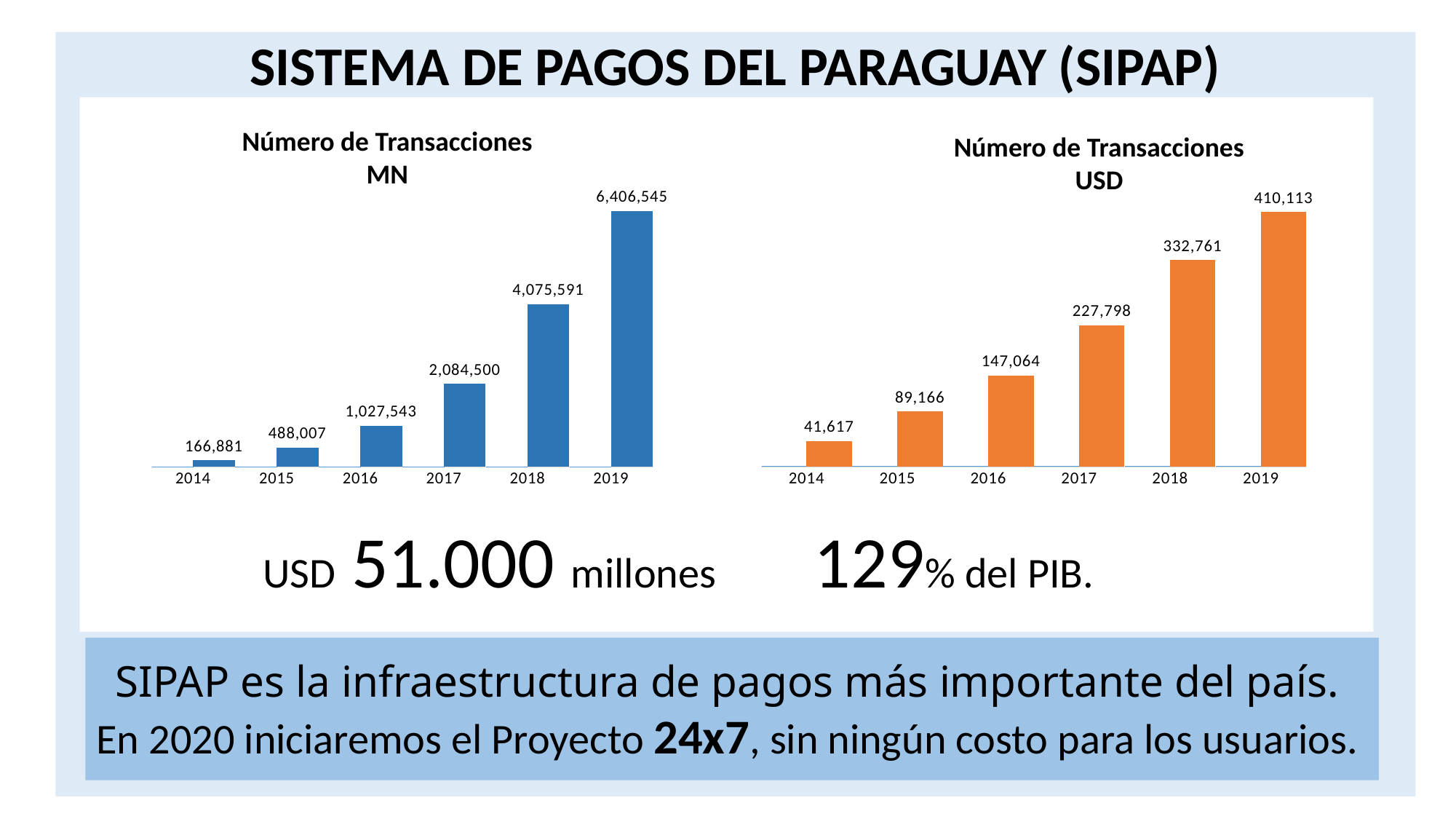
In the 'Número de Transacciones USD' chart, what is the difference between the values for 2015 and 2014? 47,549 In the 'Número de Transacciones USD' chart, which year has the highest value? 2019 How many years are shown in the 'Número de Transacciones MN' chart? 6 What colour are the bars in the 'Número de Transacciones USD' chart? Orange In the 'Número de Transacciones MN' chart, what is the value for 2019? 6,406,545 In the 'Número de Transacciones MN' chart, what is the value for 2014? 166,881 In the 'Número de Transacciones USD' chart, what is the value for 2016? 147,064 In the 'Número de Transacciones MN' chart, which year has the lowest value? 2014 In the 'Número de Transacciones USD' chart, which is larger, the value for 2017 or the value for 2018? 2018 What kind of chart is the 'Número de Transacciones USD' chart? Bar chart In the 'Número de Transacciones MN' chart, do the values rise or fall from 2014 to 2019? Rise In the 'Número de Transacciones MN' chart, what is the difference between the values for 2019 and 2018? 2,330,954